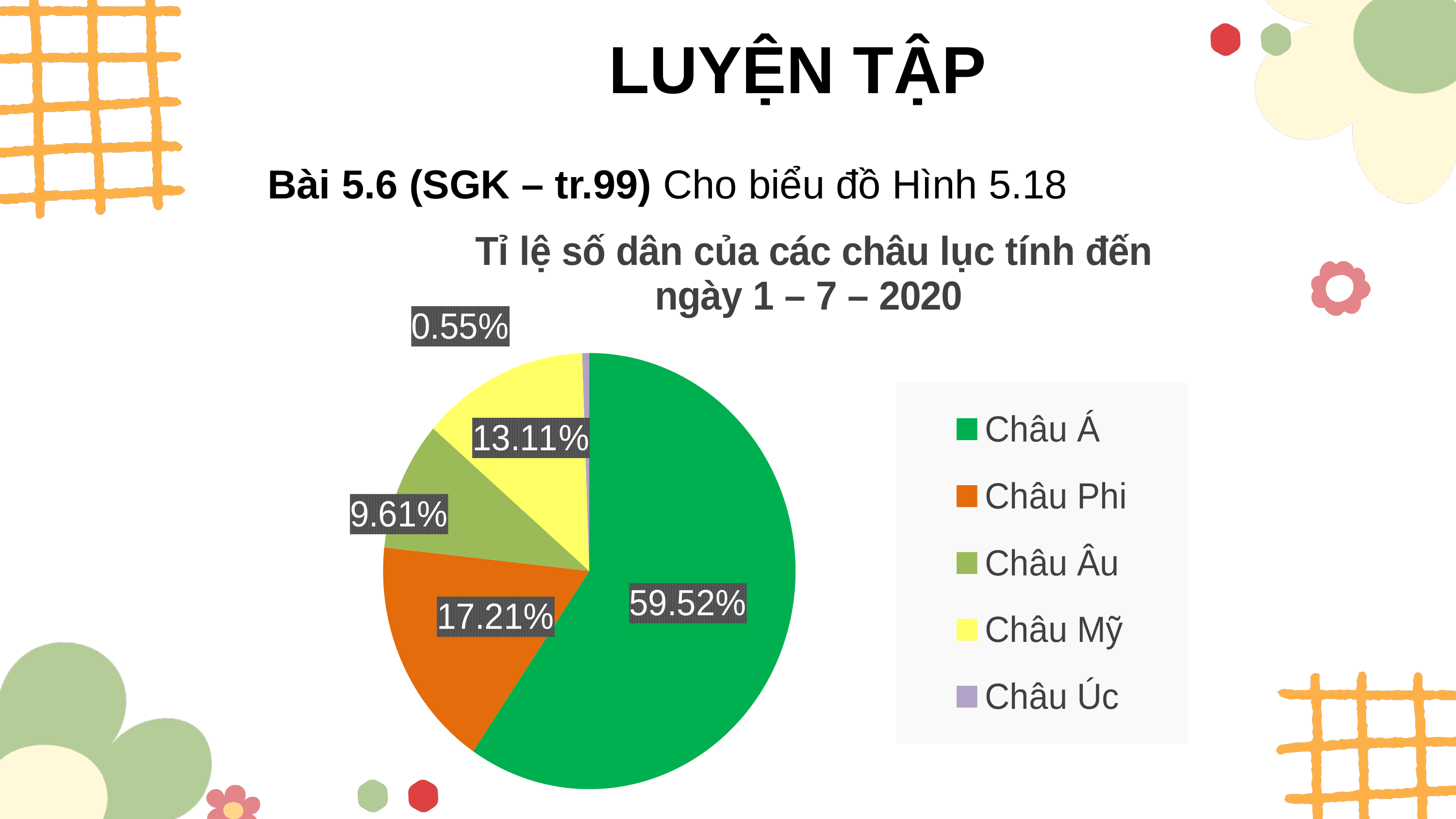
How many slices does the pie chart have? 5 What is the title of the chart? Tỉ lệ số dân của các châu lục tính đến ngày 1 – 7 – 2020 Which continent has the smallest share of the pie? Châu Úc What is the value for Châu Mỹ? 13.11% What is the difference between the values for Châu Phi and Châu Âu? 7.60% What is the value for Châu Á? 59.52% Which is larger, the value for Châu Mỹ or the value for Châu Âu? Châu Mỹ Which colour represents Châu Phi in the legend? orange Which continent has the largest share of the pie? Châu Á What is the value for Châu Phi? 17.21% What kind of chart is shown on the slide? pie chart What is the value for Châu Úc? 0.55%